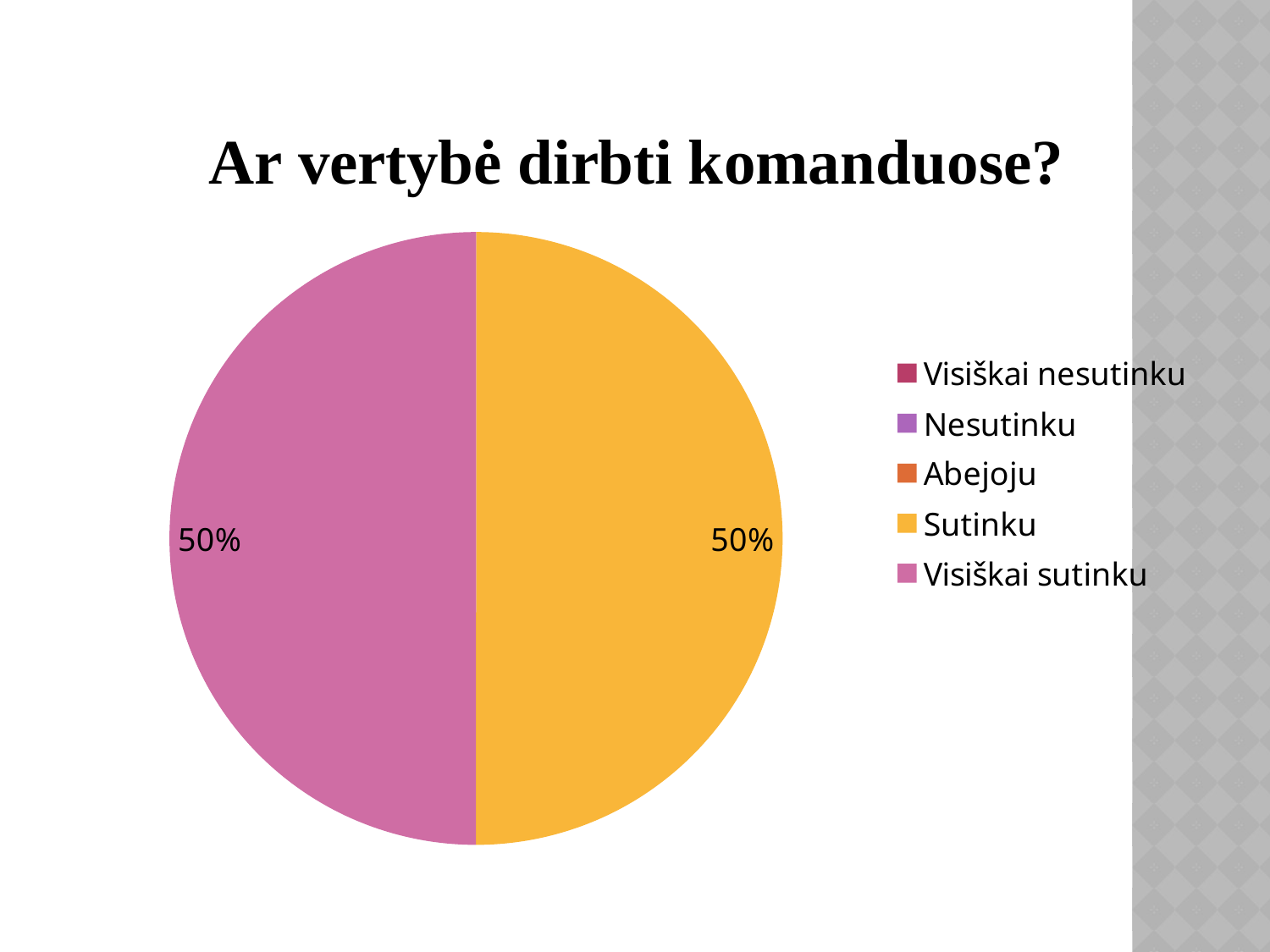
What is the difference between the Sutinku share and the Visiškai sutinku share? 0% What share of the pie does the Visiškai sutinku slice represent? 50% What kind of chart is shown on the slide? pie chart What share of the pie does the Sutinku slice represent? 50% What colour is the Visiškai sutinku slice? pink What is the combined share of the Sutinku and Visiškai sutinku slices? 100% Is the Sutinku slice larger, smaller, or equal to the Visiškai sutinku slice? equal How many entries does the legend list? 5 Which legend entry is listed first? Visiškai nesutinku What is the title of the chart? Ar vertybė dirbti komanduose? How many slices are visible in the pie chart? 2